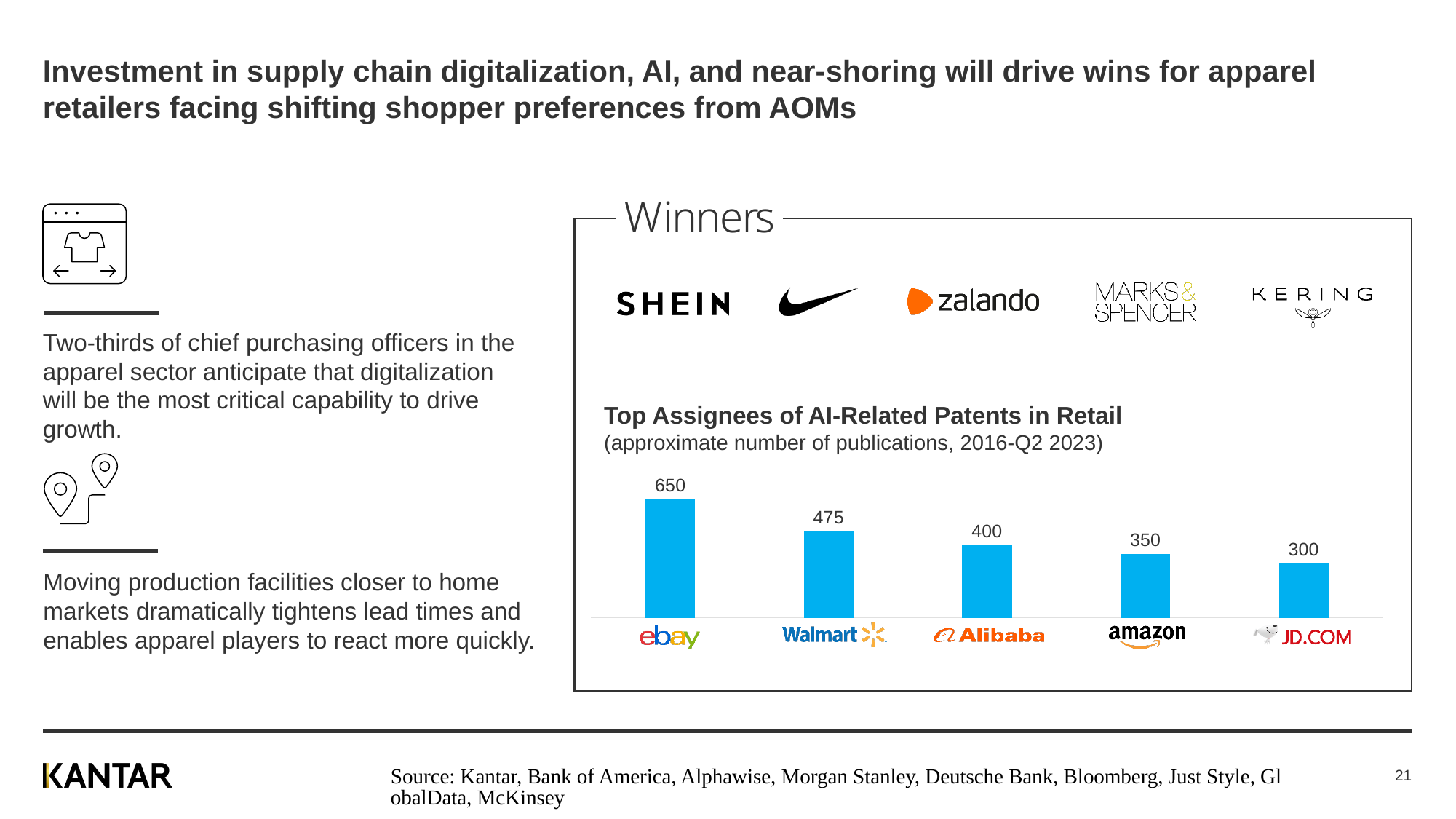
What is the value for Alibaba in the chart? 400 What is the value for JD.COM in the chart? 300 What is the value for eBay in the Top Assignees of AI-Related Patents in Retail chart? 650 What is the difference between the values for eBay and Walmart? 175 How many companies are shown in the bar chart? 5 Which company has the highest number of AI-related patent publications in the chart? eBay Which has a larger value, Alibaba or Amazon? Alibaba What is the difference between the values for Amazon and JD.COM? 50 Do the values rise or fall from left to right across the chart? Fall What is the value for Walmart in the chart? 475 What kind of chart is used to show the top assignees of AI-related patents in retail? Bar chart Which company has the lowest number of AI-related patent publications in the chart? JD.COM